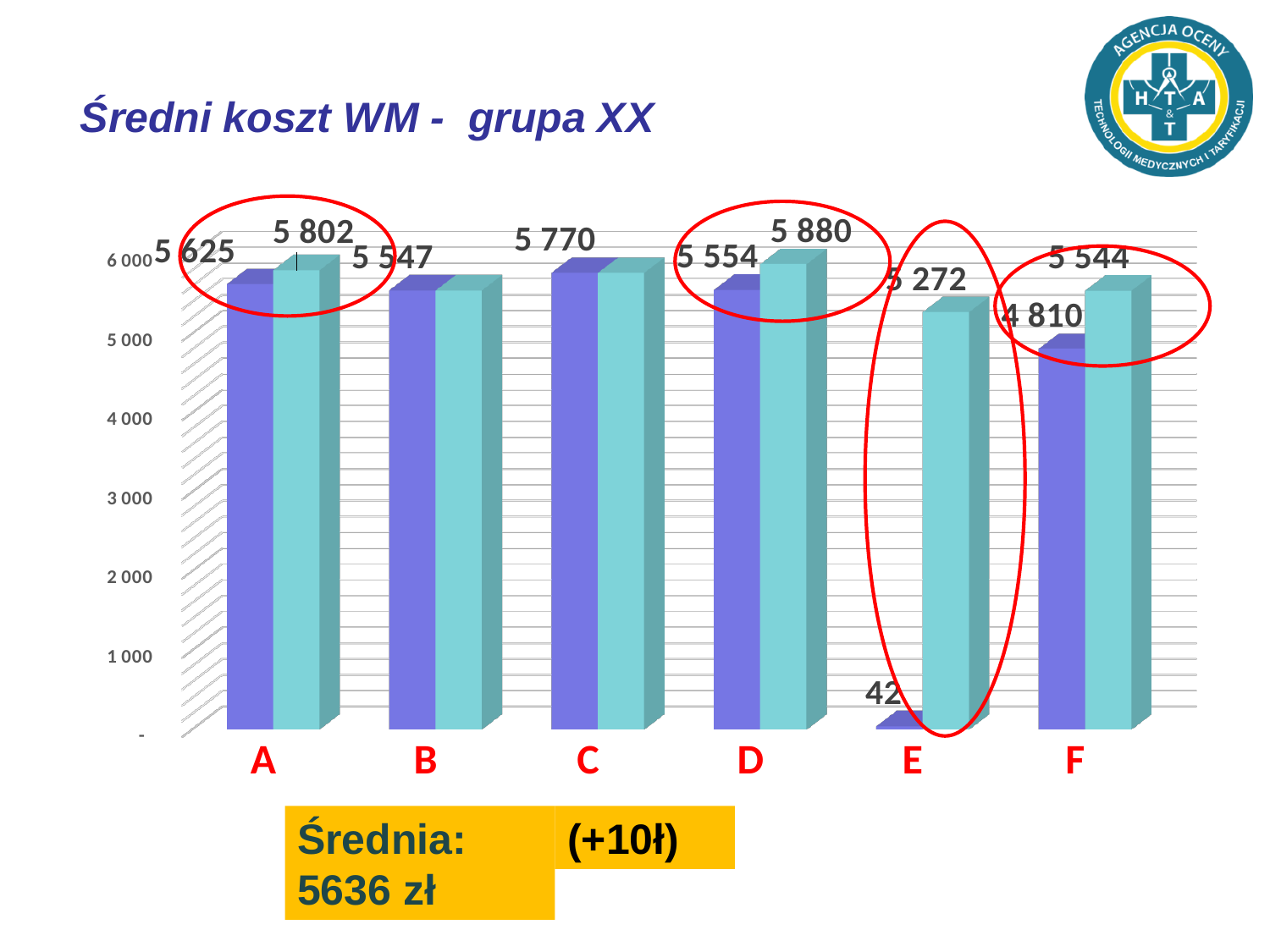
What is the value shown on the light blue bar for category D? 5 880 Is the value of the purple bar for category F greater or less than 5 000? less Which is larger: the light blue bar for category D or the light blue bar for category A? Category D What type of chart is shown on the slide? Bar chart Which category has the lowest labelled value on the chart? E What is the value shown on the purple bar for category F? 4 810 How many categories are shown on the x axis? 6 What is the value shown on the purple bar for category E? 42 What is the value shown on the light blue bar for category A? 5 802 What is the value shown on the purple bar for category A? 5 625 What is the difference between the light blue bar and the purple bar for category A? 177 What is the difference between the light blue bar and the purple bar for category F? 734